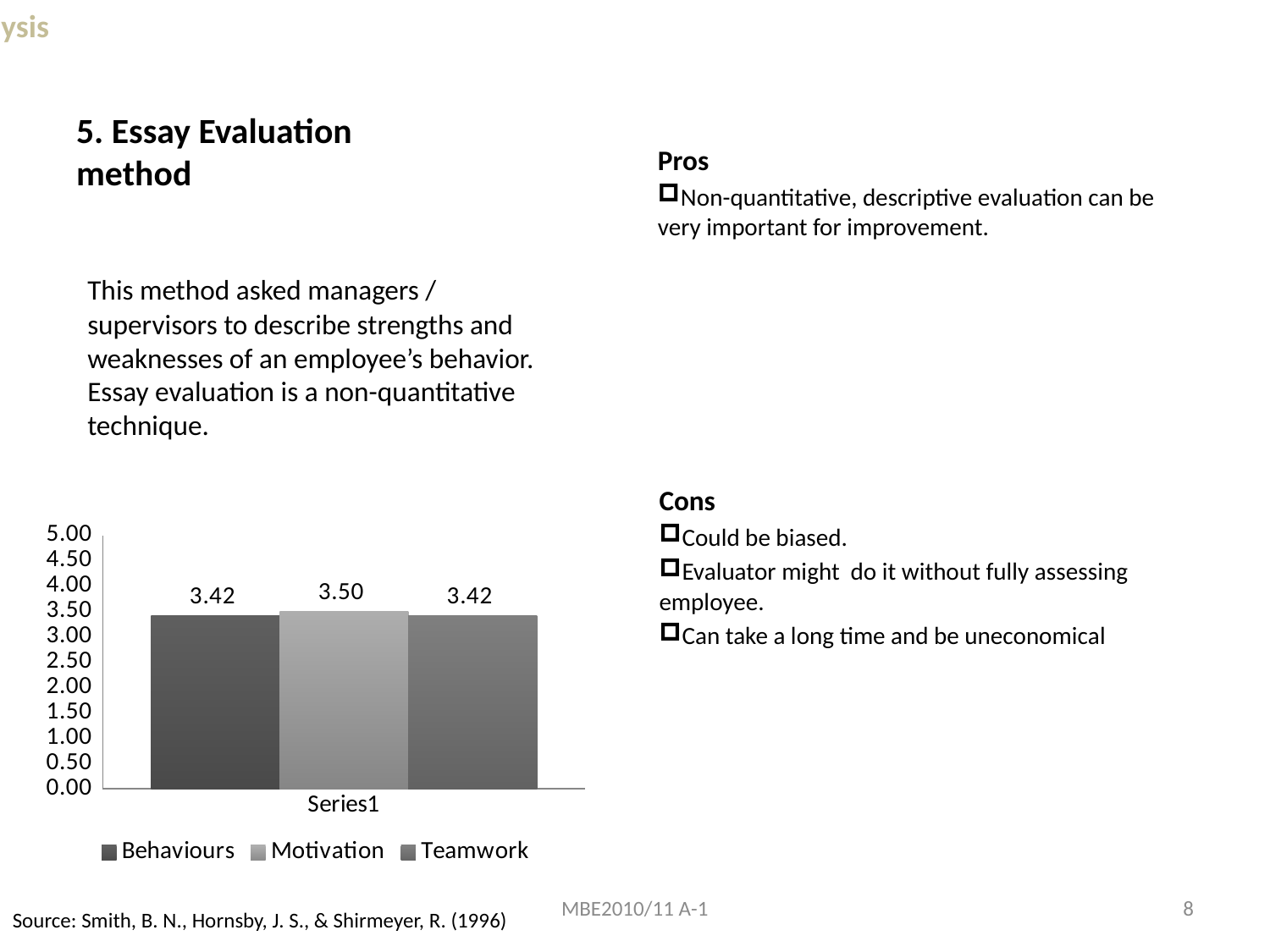
What kind of chart is shown on the slide? bar chart What is the label of the category on the x axis of the chart? Series1 Which series has the highest value in the chart? Motivation Which is larger, the Motivation value or the Teamwork value? Motivation What is the value of the Teamwork bar in the chart? 3.42 Is the value for Behaviours greater or less than 3.00? greater How many series does the chart legend list? 3 What is the difference between the Motivation value and the Behaviours value? 0.08 How many categories are shown on the x axis of the chart? 1 Is the value for Motivation greater or less than 4.00? less What is the value of the Motivation bar in the chart? 3.50 What is the value of the Behaviours bar in the chart? 3.42